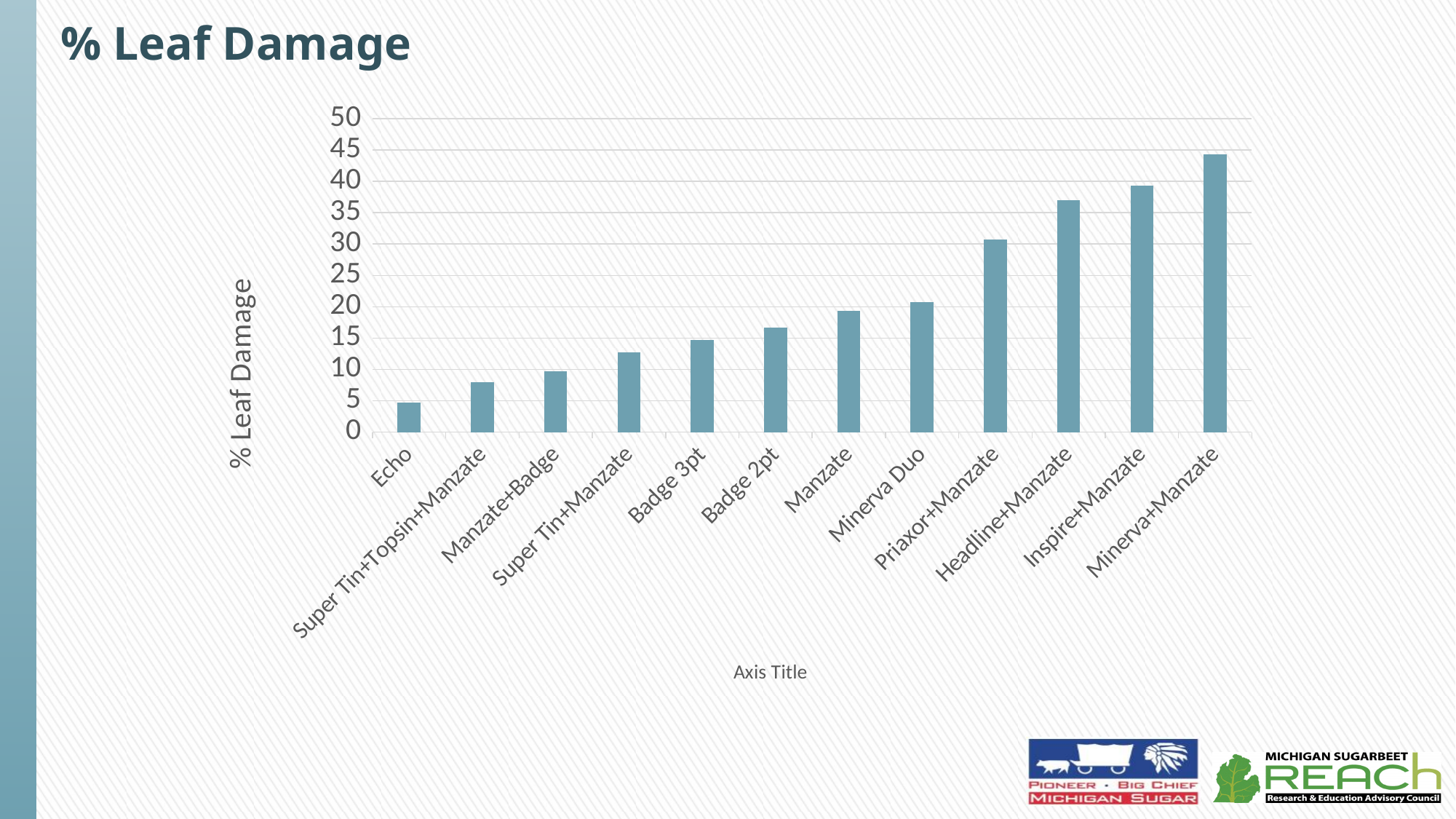
Is the value for Badge 2pt greater or less than 20? less What is the label on the vertical axis of the chart? % Leaf Damage Is the value for Minerva+Manzate greater or less than 40? greater Is the value for Priaxor+Manzate greater or less than 30? greater Which has a lower % leaf damage, Super Tin+Manzate or Minerva Duo? Super Tin+Manzate What kind of chart is shown on the slide? bar chart Which category has the highest % leaf damage? Minerva+Manzate How many categories are plotted on the x axis? 12 Do the values rise or fall moving from left to right along the x axis? rise Which has a higher % leaf damage, Headline+Manzate or Manzate? Headline+Manzate Which category has the lowest % leaf damage? Echo